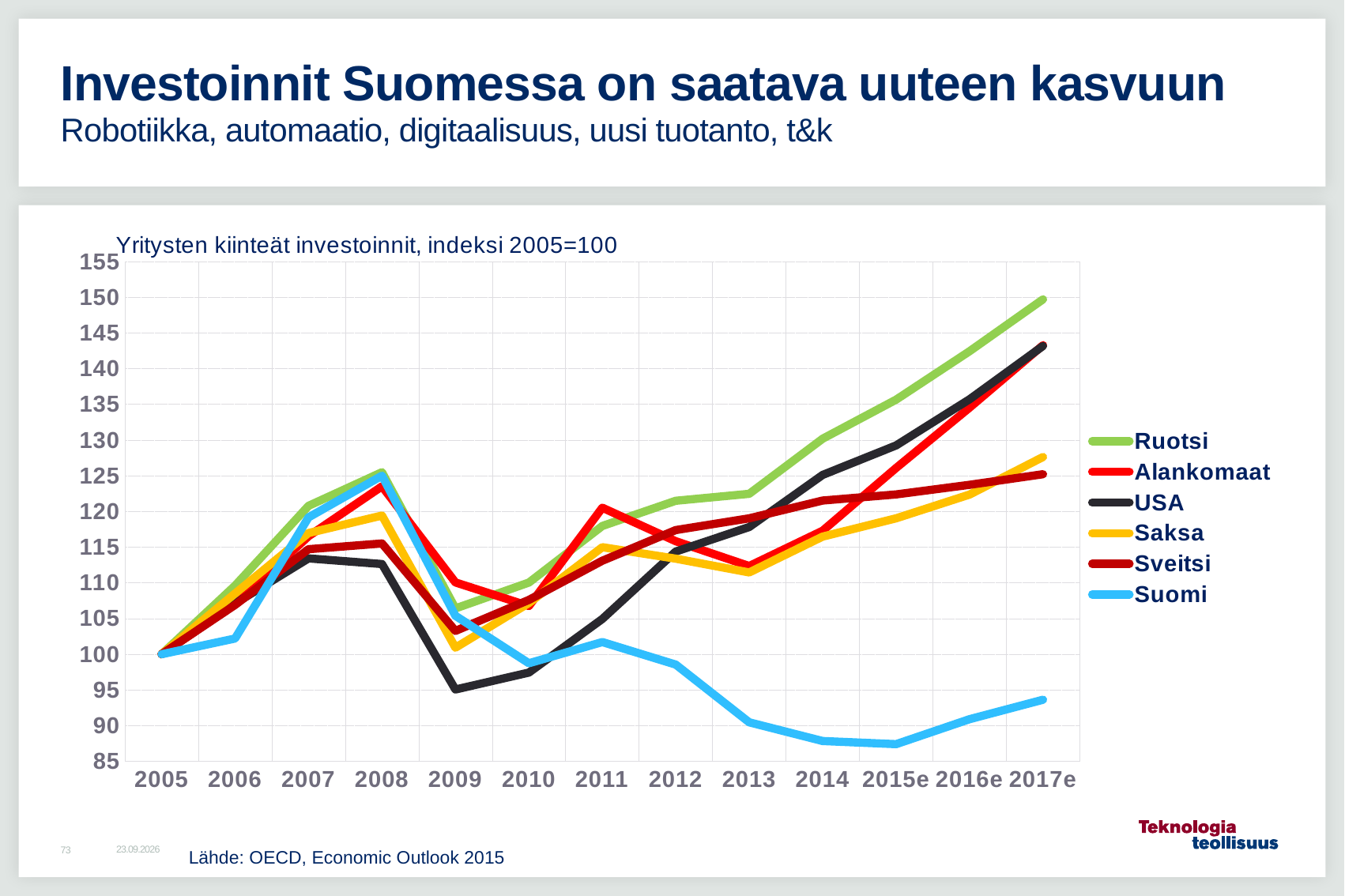
What is the index value for Suomi in 2005? 100 Which series has the lowest value in 2017e? Suomi What kind of chart is shown on the slide? line chart Which is larger in 2017e, the value for USA or the value for Saksa? USA Is the value for Suomi in 2017e greater or less than 95? less How many years are shown on the x axis? 13 Is the value for Ruotsi in 2017e greater or less than 145? greater Which series has the highest value in 2017e? Ruotsi Does the Suomi line rise or fall from 2011 to 2015e? fall How many series does the legend list? 6 Is the value for Suomi in 2015e greater or less than 90? less What is the title of the chart? Yritysten kiinteät investoinnit, indeksi 2005=100